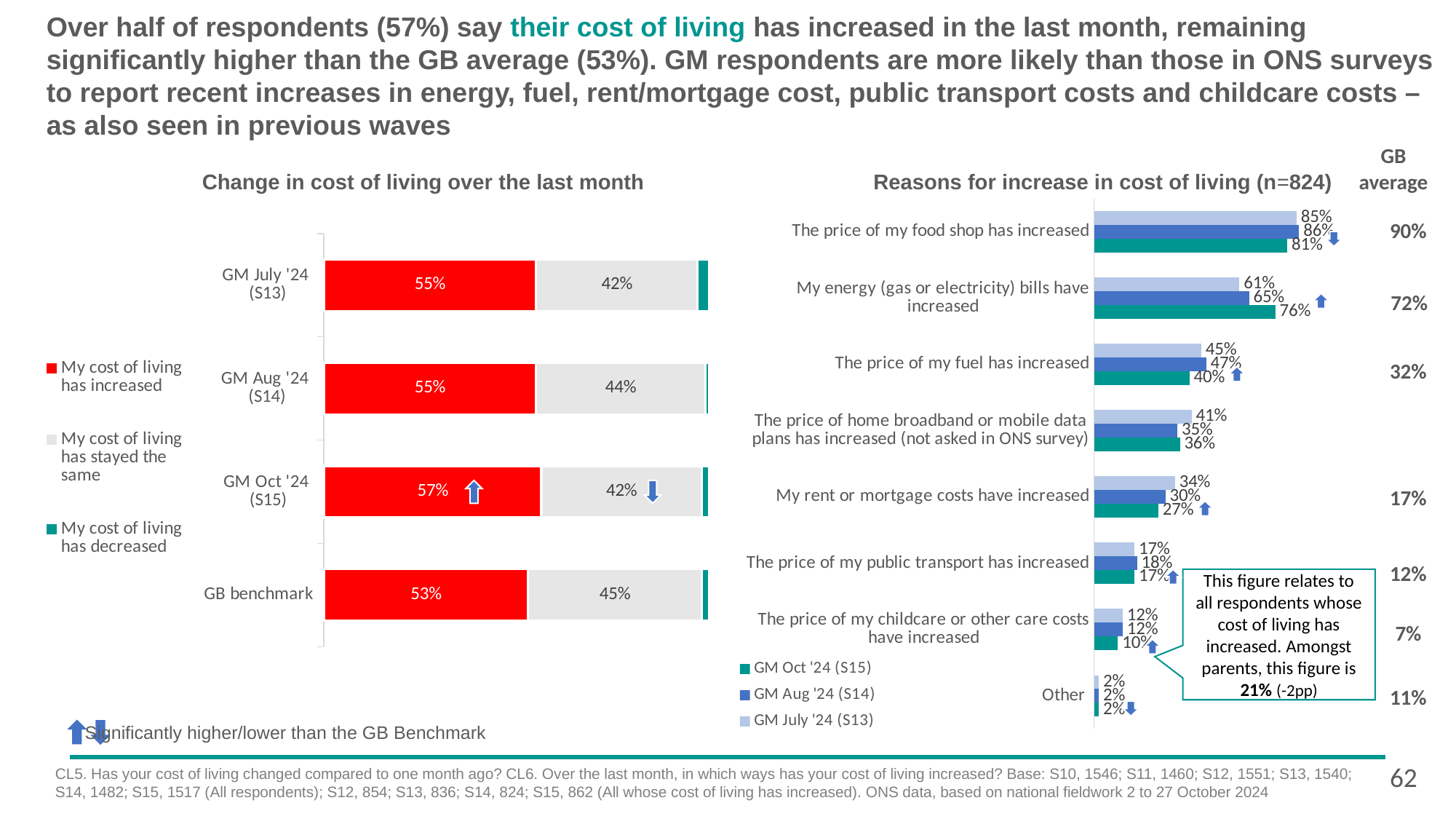
What kind of chart is 'Change in cost of living over the last month'? Stacked bar chart In the 'Reasons for increase in cost of living (n=824)' chart, what is the GM Aug '24 (S14) value for 'The price of my food shop has increased'? 86% In the 'Reasons for increase in cost of living (n=824)' chart, which reason has the highest GM Oct '24 (S15) value? The price of my food shop has increased In the 'Change in cost of living over the last month' chart, what is the difference between the GM Oct '24 (S15) and GB benchmark shares saying their cost of living has increased? 4 percentage points In the 'Reasons for increase in cost of living (n=824)' chart, what is the difference between the GM Oct '24 (S15) value and the GM July '24 (S13) value for 'My rent or mortgage costs have increased'? 7 percentage points In the 'Reasons for increase in cost of living (n=824)' chart, what is the GM Oct '24 (S15) value for 'My energy (gas or electricity) bills have increased'? 76% In the 'Reasons for increase in cost of living (n=824)' chart, how many reason categories are plotted? 8 In the 'Change in cost of living over the last month' chart, what percentage of GM Oct '24 (S15) respondents say their cost of living has increased? 57% In the 'Change in cost of living over the last month' chart, which wave or benchmark has the highest share saying their cost of living has increased? GM Oct '24 (S15) In the 'Change in cost of living over the last month' chart, what percentage of the GB benchmark say their cost of living has stayed the same? 45% In the 'Reasons for increase in cost of living (n=824)' chart, which is larger for 'The price of my fuel has increased': the GM Aug '24 (S14) value or the GM Oct '24 (S15) value? GM Aug '24 (S14) In the 'Change in cost of living over the last month' chart, how many series does the legend list? 3